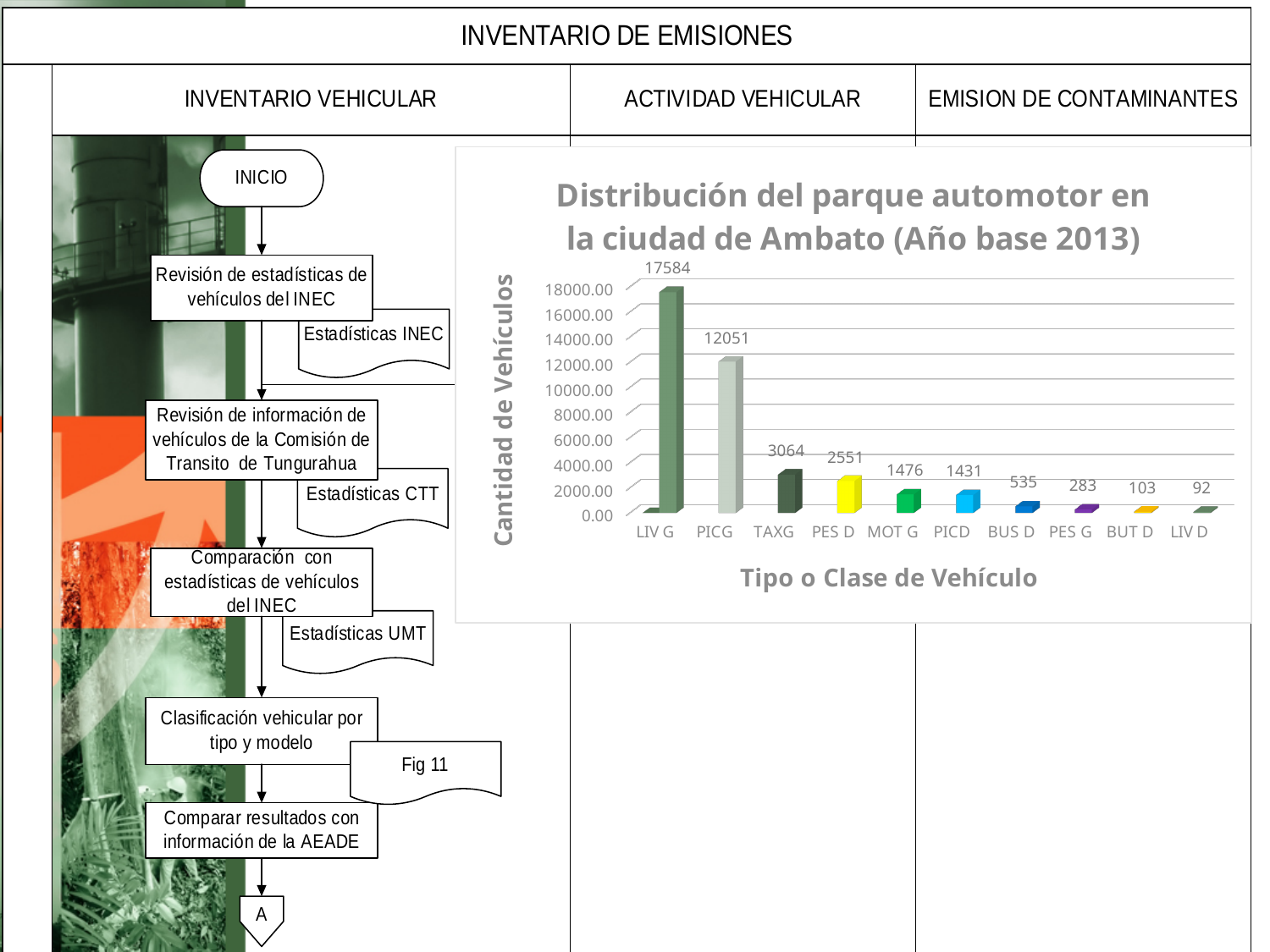
What is the value for LIV G? 17584 What is the value for PICG? 12051 What kind of chart is shown? bar chart What is the difference between the values for LIV G and PICG? 5533 How many vehicle types are shown on the x axis? 10 What is the difference between the values for TAXG and PES D? 513 What is the value for BUS D? 535 Is the value for TAXG greater or less than 4000.00? less Which vehicle type has the highest value? LIV G Which is larger, the value for MOT G or the value for PICD? MOT G What is the title of the chart? Distribución del parque automotor en la ciudad de Ambato (Año base 2013) Which vehicle type has the lowest value? LIV D